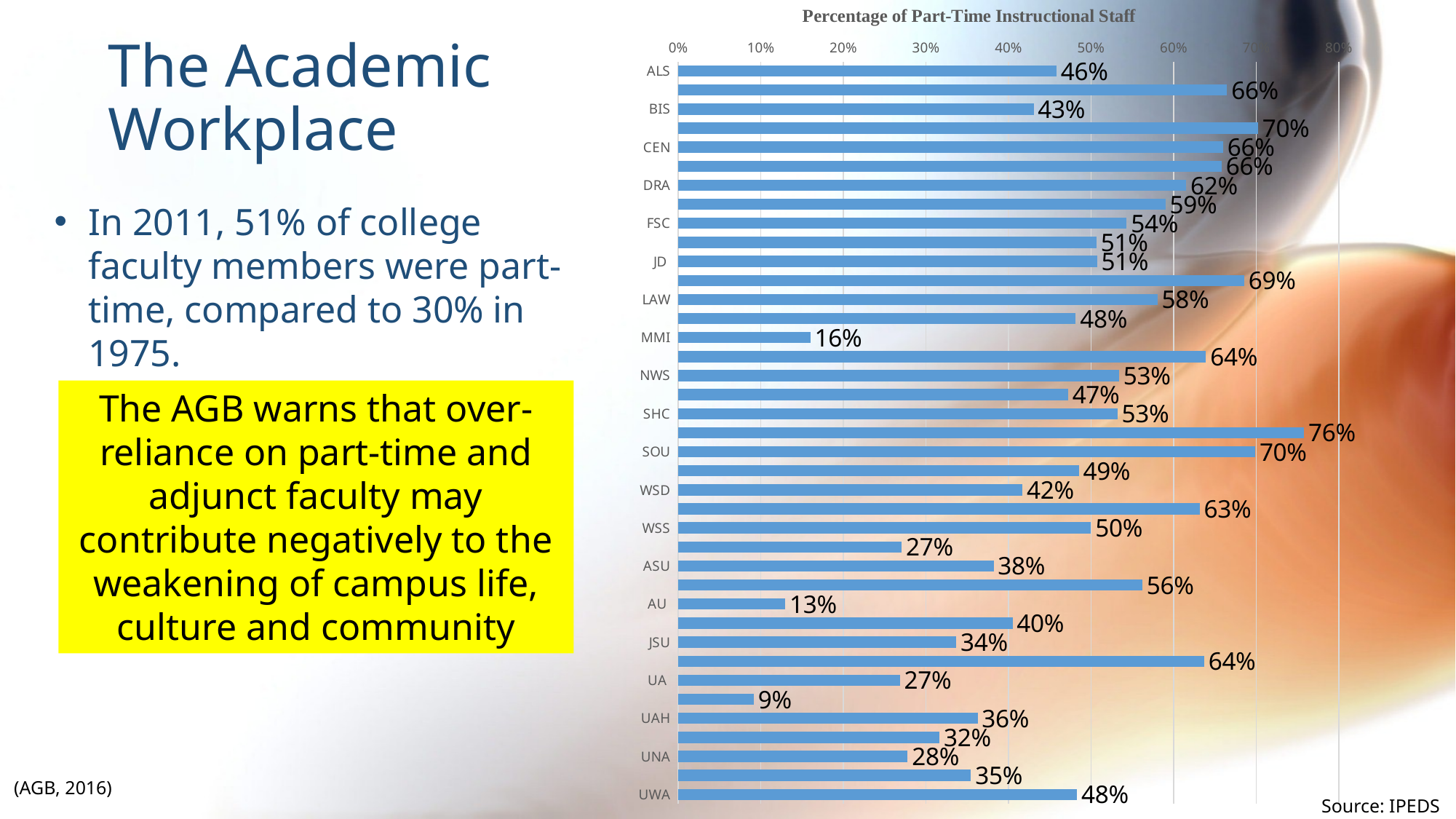
What is the value for AU? 13% What kind of chart is shown on the slide? bar chart What is the value for ALS? 46% What is the difference between the values for CEN and DRA? 4 percentage points What is the title of the chart? Percentage of Part-Time Instructional Staff Which has the larger value, NWS or JD? NWS Is the value for WSD greater or less than 50%? less What is the value for SOU? 70% What is the value for MMI? 16% Which has the larger value, LAW or FSC? LAW What is the value for UWA? 48% What is the highest value shown on the chart? 76%